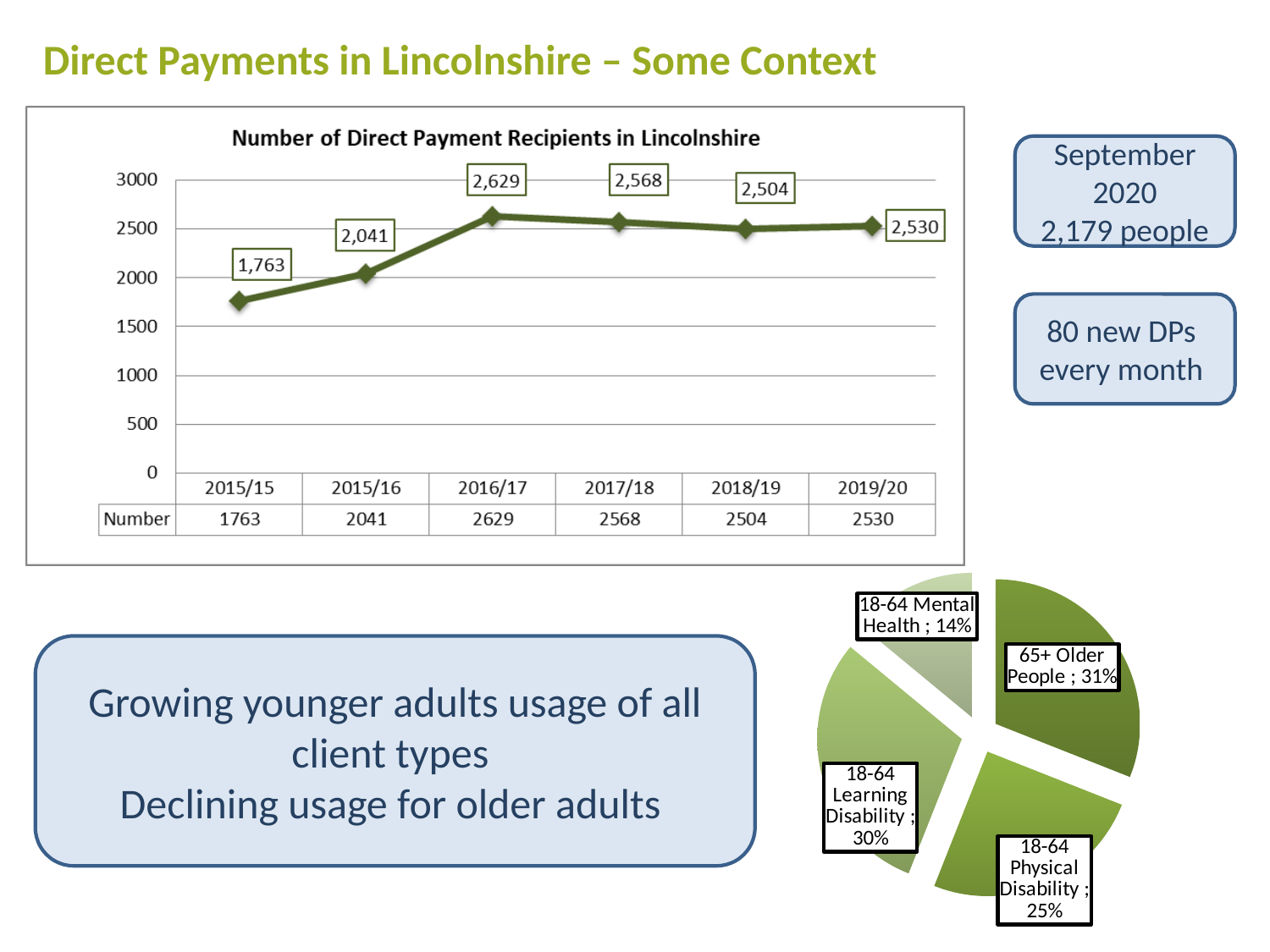
In the line chart 'Number of Direct Payment Recipients in Lincolnshire', which year has the highest number of recipients? 2016/17 In the line chart 'Number of Direct Payment Recipients in Lincolnshire', what is the difference between the values for 2016/17 and 2015/15? 866 In the line chart 'Number of Direct Payment Recipients in Lincolnshire', how many years are plotted? 6 In the line chart 'Number of Direct Payment Recipients in Lincolnshire', which year has the lowest number of recipients? 2015/15 In the line chart 'Number of Direct Payment Recipients in Lincolnshire', do the values rise or fall from 2015/15 to 2016/17? Rise In the line chart 'Number of Direct Payment Recipients in Lincolnshire', what is the value for 2016/17? 2,629 In the line chart 'Number of Direct Payment Recipients in Lincolnshire', what is the value for 2015/15? 1,763 In the pie chart at the bottom right, how many slices are there? 4 In the line chart 'Number of Direct Payment Recipients in Lincolnshire', which is larger, the value for 2017/18 or the value for 2019/20? 2017/18 In the pie chart at the bottom right, which client type has the smallest share? 18-64 Mental Health What kind of chart is 'Number of Direct Payment Recipients in Lincolnshire'? Line chart In the pie chart at the bottom right, what share is 65+ Older People? 31%